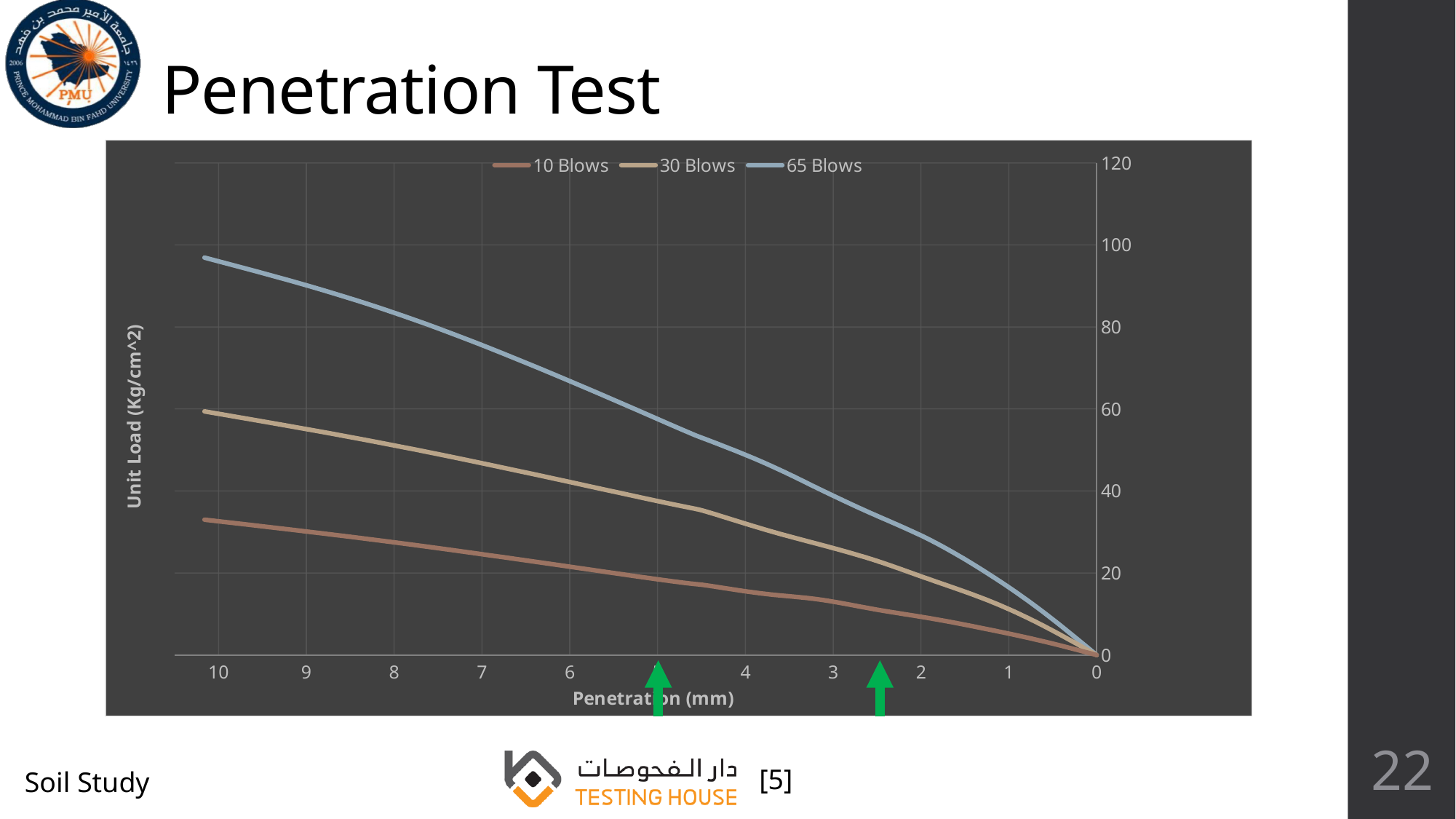
Which series has the highest unit load at a penetration of 10 mm? 65 Blows What is the title of the vertical axis? Unit Load (Kg/cm^2) What are the series names listed in the legend? 10 Blows, 30 Blows, 65 Blows What kind of chart is shown on the slide? line chart Is the unit load for 65 Blows at 10 mm penetration greater or less than 80? greater Which series has the lowest unit load at a penetration of 10 mm? 10 Blows Do the unit load values rise or fall as you move from left to right along the x axis? fall At 5 mm penetration, which is larger: the unit load for 30 Blows or for 10 Blows? 30 Blows How many series does the legend list? 3 Is the unit load for 10 Blows at 10 mm penetration greater or less than 40? less Is the unit load for 65 Blows at 5 mm penetration greater or less than 40? greater